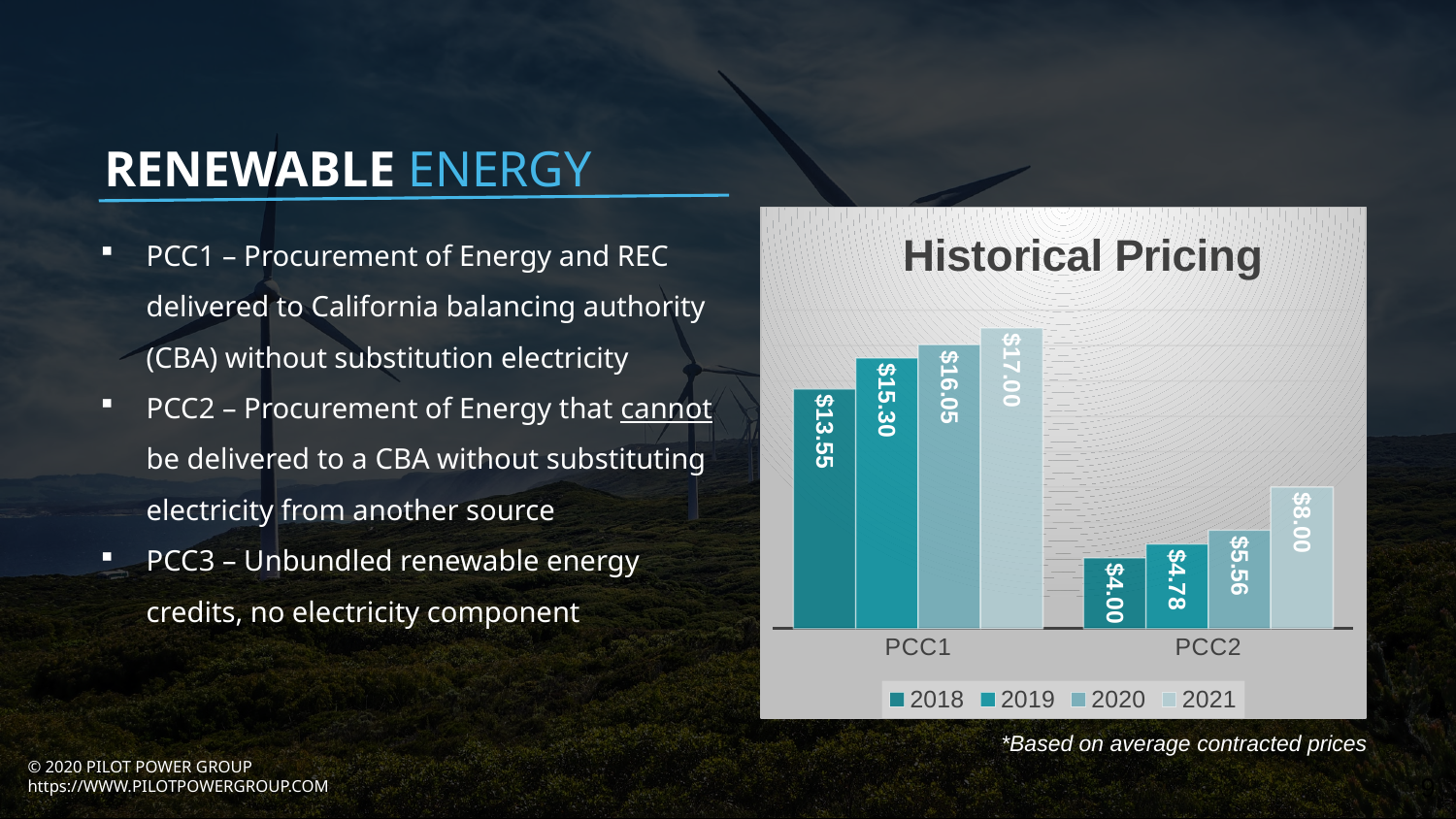
Which is larger in the Historical Pricing chart: the 2019 value for PCC1 or the 2021 value for PCC2? 2019 value for PCC1 What is the difference between the 2021 and 2018 values for PCC1 in the Historical Pricing chart? $3.45 Which year has the highest value for PCC1 in the Historical Pricing chart? 2021 What is the 2018 value for PCC1 in the Historical Pricing chart? $13.55 What is the 2019 value for PCC2 in the Historical Pricing chart? $4.78 Which year has the lowest value for PCC2 in the Historical Pricing chart? 2018 Do the PCC2 values rise or fall from 2018 to 2021 in the Historical Pricing chart? Rise What kind of chart is the Historical Pricing chart? Bar chart How many series does the legend of the Historical Pricing chart list? 4 What is the difference between the 2021 and 2020 values for PCC2 in the Historical Pricing chart? $2.44 What is the 2020 value for PCC1 in the Historical Pricing chart? $16.05 What is the 2021 value for PCC2 in the Historical Pricing chart? $8.00